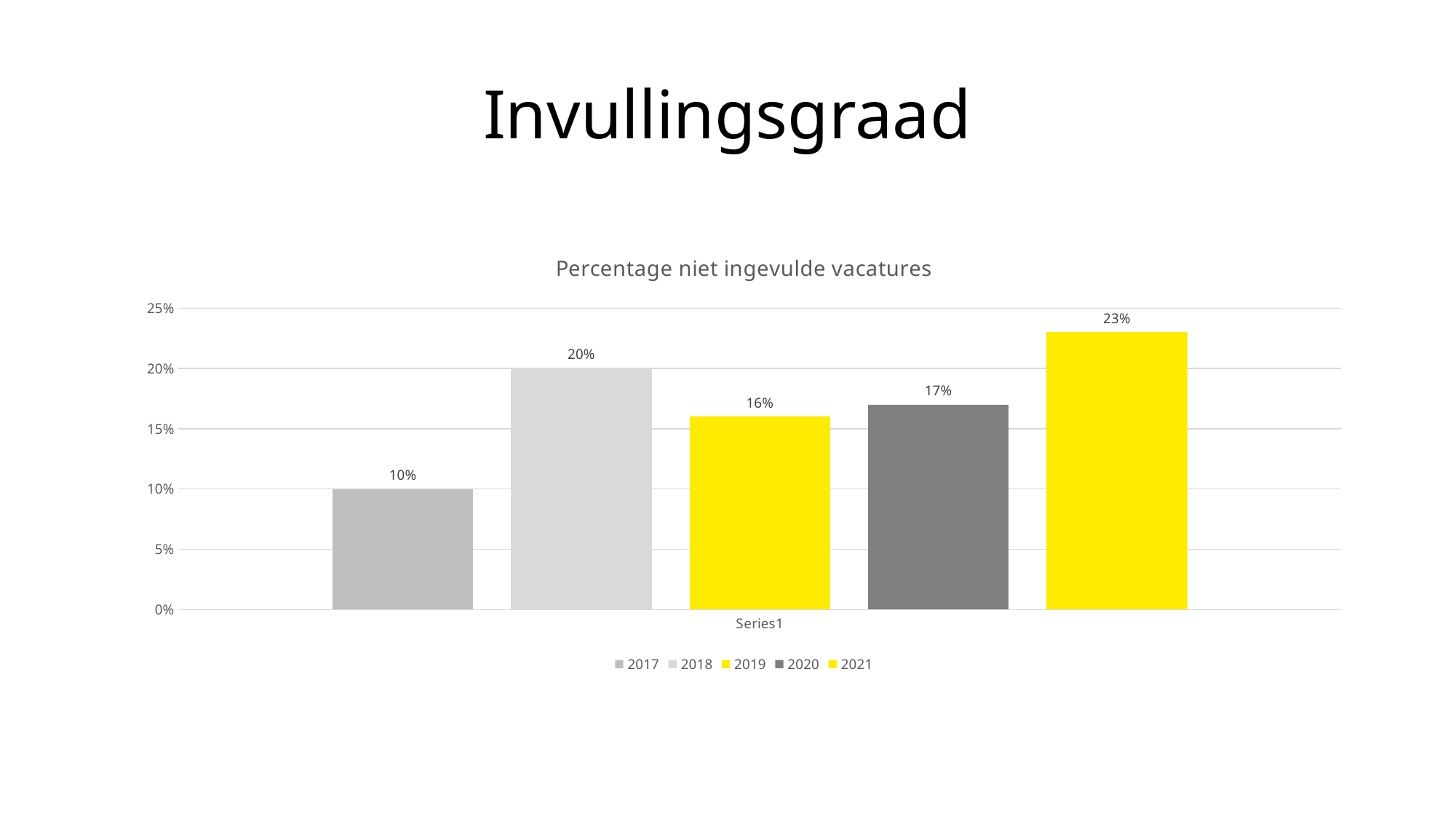
What is the value for 2019? 16% What is the value for 2021? 23% What is the title of the chart? Percentage niet ingevulde vacatures What is the value for 2017? 10% How many years are shown in the legend? 5 What is the difference between the values for 2021 and 2017? 13% How many bars are plotted in the chart? 5 Which is larger, the value for 2018 or the value for 2020? 2018 Which year has the lowest percentage of unfilled vacancies? 2017 Which year has the highest percentage of unfilled vacancies? 2021 What kind of chart is shown on the slide? Bar chart What is the difference between the values for 2018 and 2019? 4%